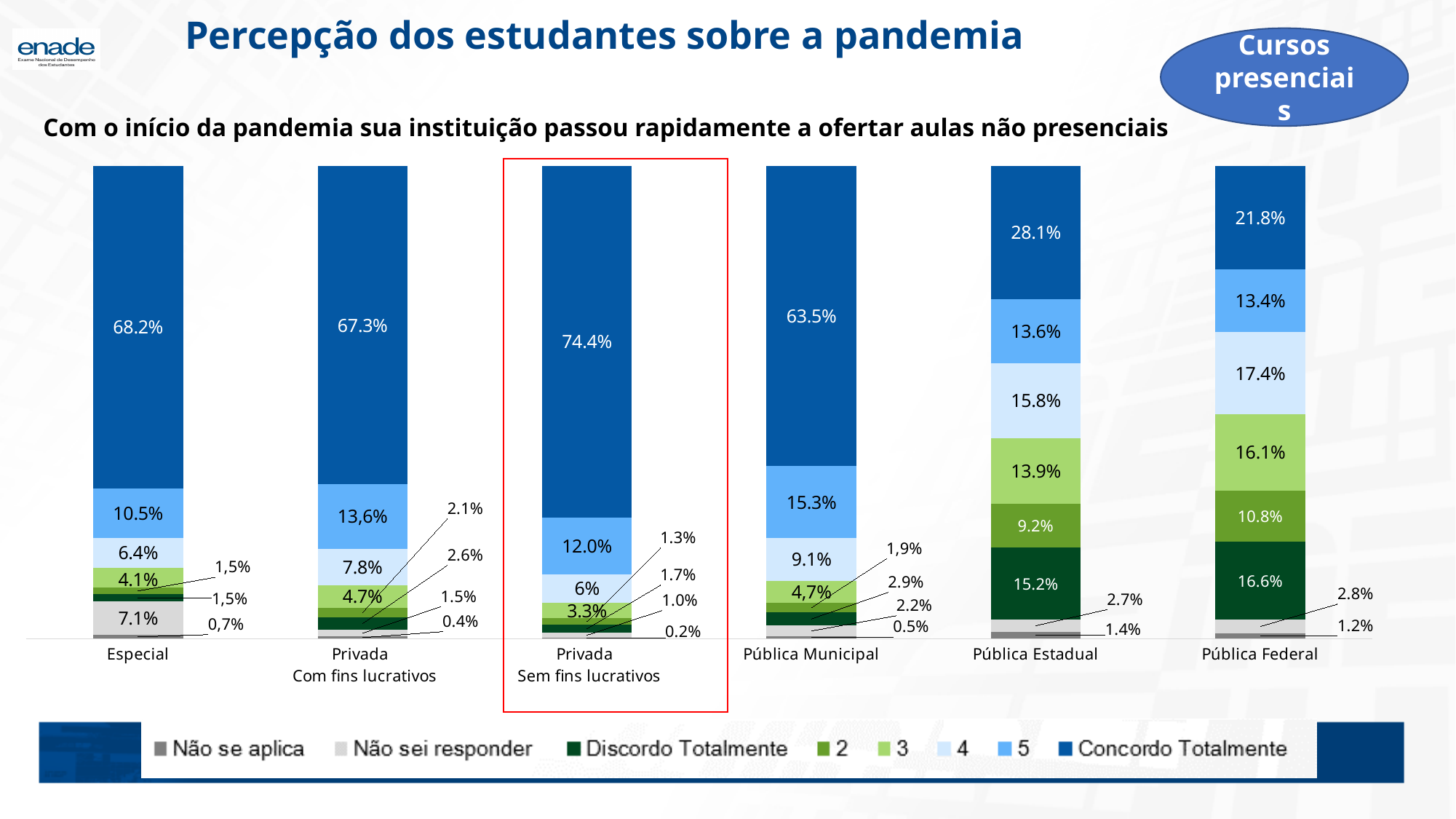
Which category has the lowest 'Concordo Totalmente' value? Pública Federal What is the value of series '5' for Pública Municipal? 15.3% What kind of chart is shown on the slide? Stacked bar chart What is the difference between the 'Concordo Totalmente' values for Privada Sem fins lucrativos and Pública Municipal? 10.9 percentage points What is the value of series '4' for Pública Federal? 17.4% Which has a larger 'Concordo Totalmente' value, Pública Estadual or Pública Federal? Pública Estadual What is the 'Concordo Totalmente' value for Privada Sem fins lucrativos? 74.4% How many institution categories are shown along the x axis of the chart? 6 How many series does the chart legend list? 8 Which category has the highest 'Concordo Totalmente' value? Privada Sem fins lucrativos What is the 'Discordo Totalmente' value for Pública Federal? 16.6% Which category's bar is highlighted with a red box on the slide? Privada Sem fins lucrativos